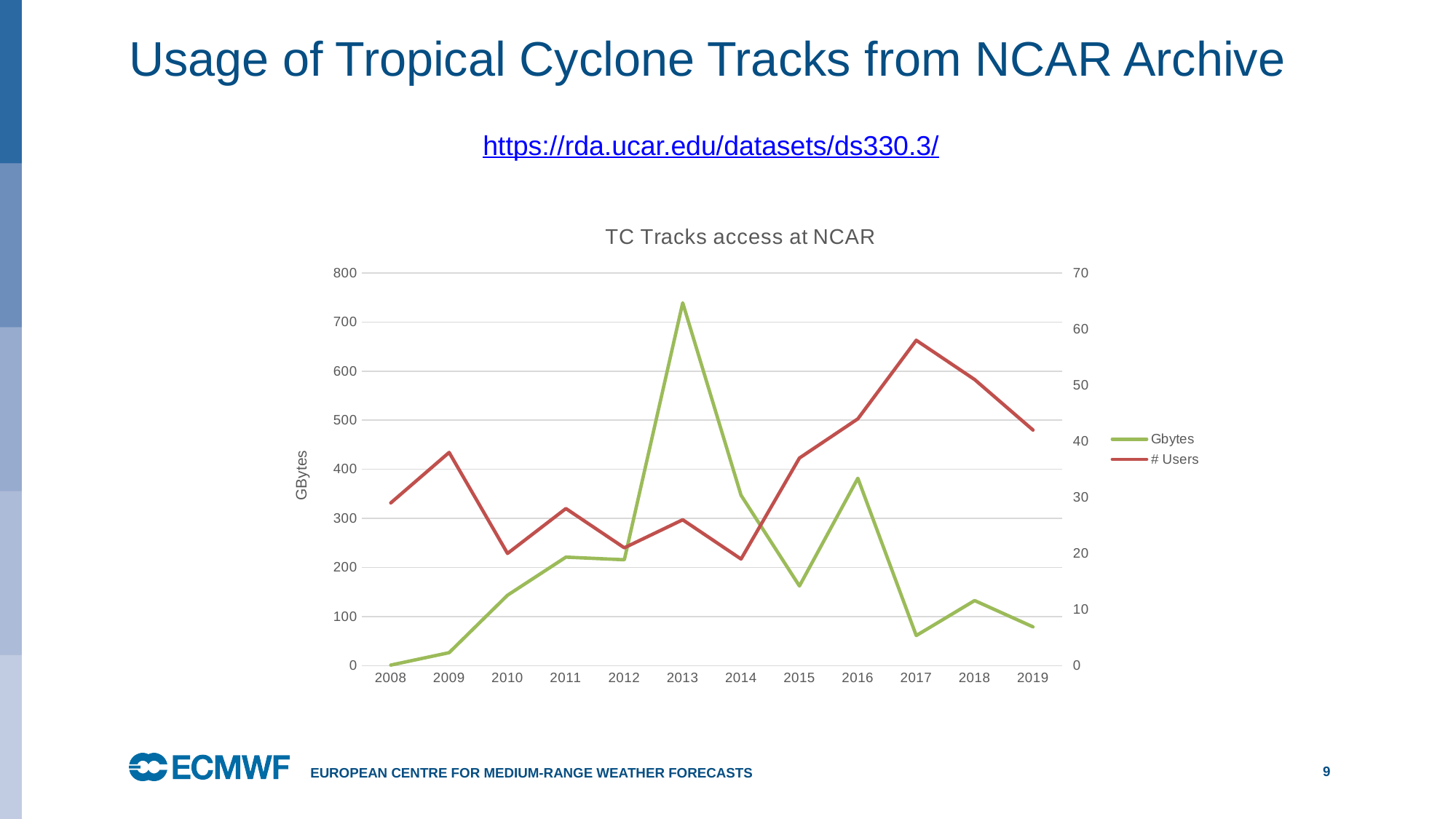
Does the # Users series rise or fall from 2014 to 2017? rise In which year does the Gbytes series reach its highest value? 2013 How many years are plotted along the x axis? 12 Is the Gbytes value for 2015 greater or less than 200? less Which year has the larger Gbytes value, 2013 or 2016? 2013 In which year does the # Users series reach its highest value? 2017 Is the Gbytes value for 2013 greater or less than 700? greater Is the # Users value for 2017 greater or less than 50? greater In which year is the Gbytes value lowest? 2008 How many series does the legend list? 2 What is the title of the chart? TC Tracks access at NCAR What kind of chart is shown on the slide? line chart